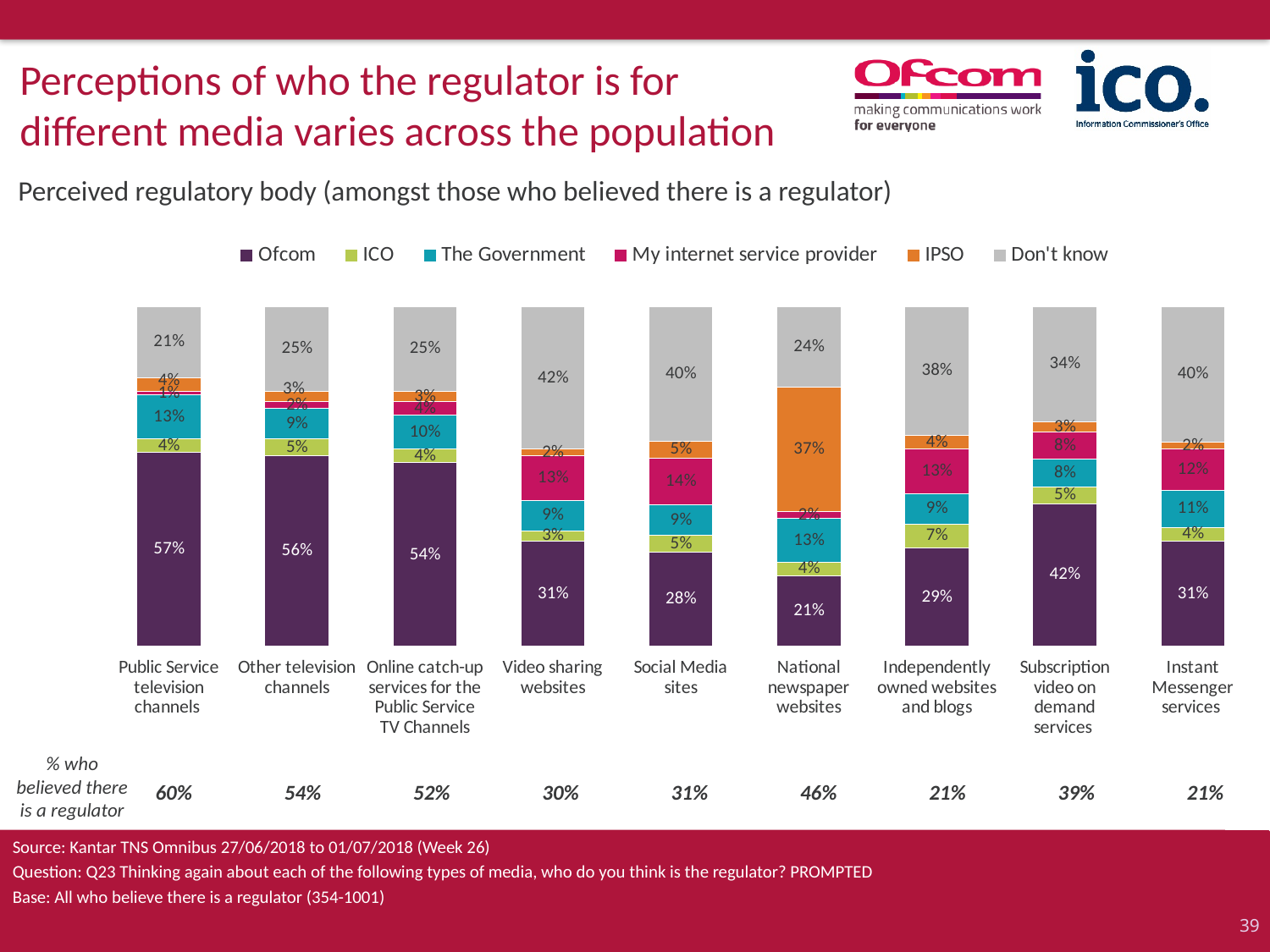
What percentage named 'My internet service provider' as the regulator for Social Media sites? 14% Which has a larger 'Don't know' share: Video sharing websites or Subscription video on demand services? Video sharing websites What percentage of respondents perceived Ofcom as the regulator for Public Service television channels? 57% What is the difference between the Ofcom percentage for Public Service television channels and for Social Media sites? 29 percentage points Which media type has the highest Ofcom percentage? Public Service television channels How many media types are shown on the x axis of the chart? 9 How many series does the chart legend list? 6 What is the 'Don't know' share for Video sharing websites? 42% What type of chart is shown on the slide? Stacked bar chart What percentage named IPSO as the regulator for National newspaper websites? 37% Which media type has the lowest Ofcom percentage? National newspaper websites According to the row below the chart, what percentage believed there is a regulator for Instant Messenger services? 21%